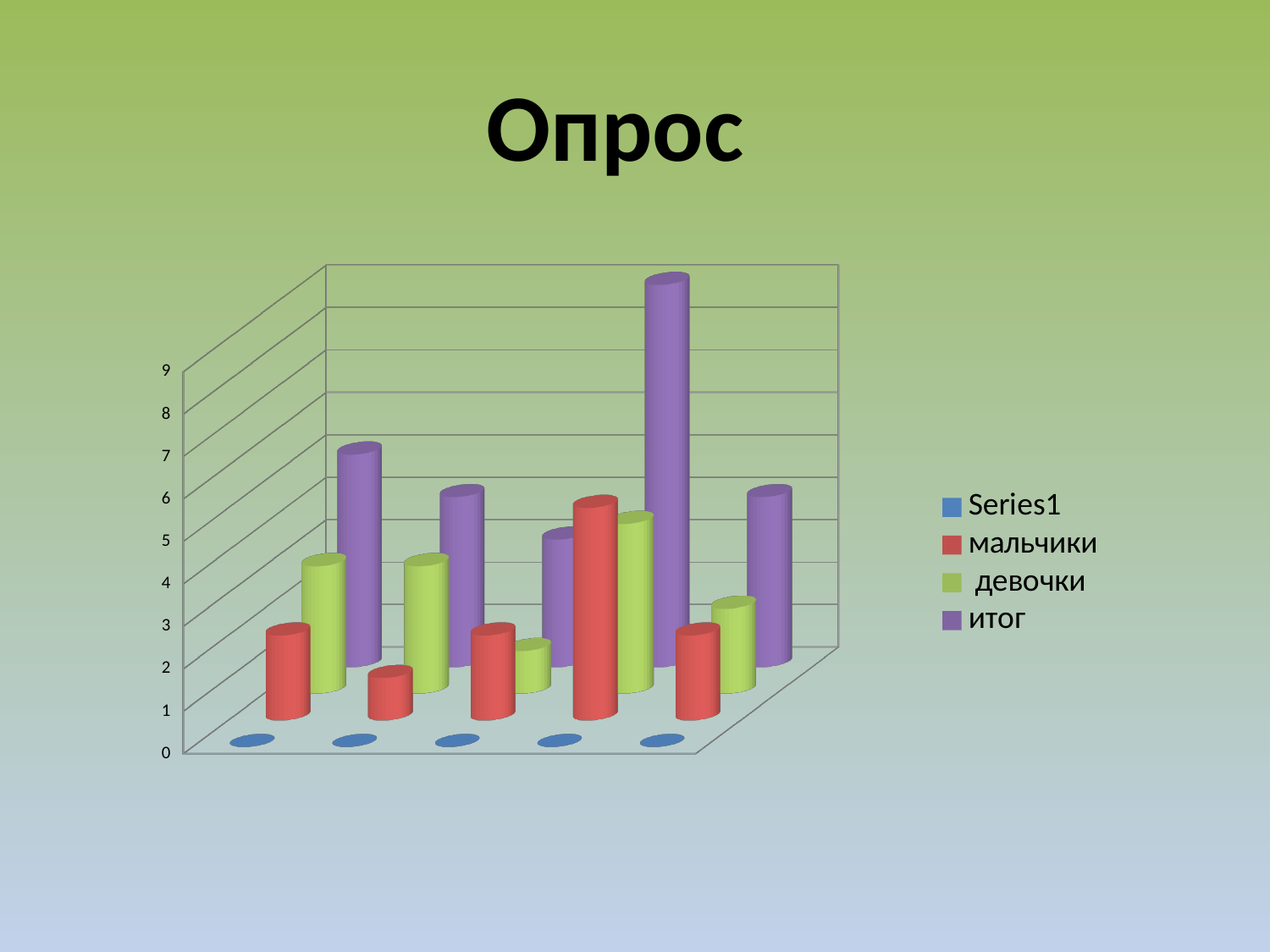
What kind of chart is shown on the slide? bar chart Which series has the tallest bar in the chart? итог How many groups of bars are plotted along the x axis? 5 In the fourth group from the left, which is larger: the bar for мальчики or the bar for итог? итог What is the title of the slide containing the chart? Опрос Which colour represents the series "итог" in the legend? purple What is the highest value shown on the vertical axis? 9 In the first group from the left, which is larger: the bar for мальчики or the bar for девочки? девочки How many series does the legend list? 4